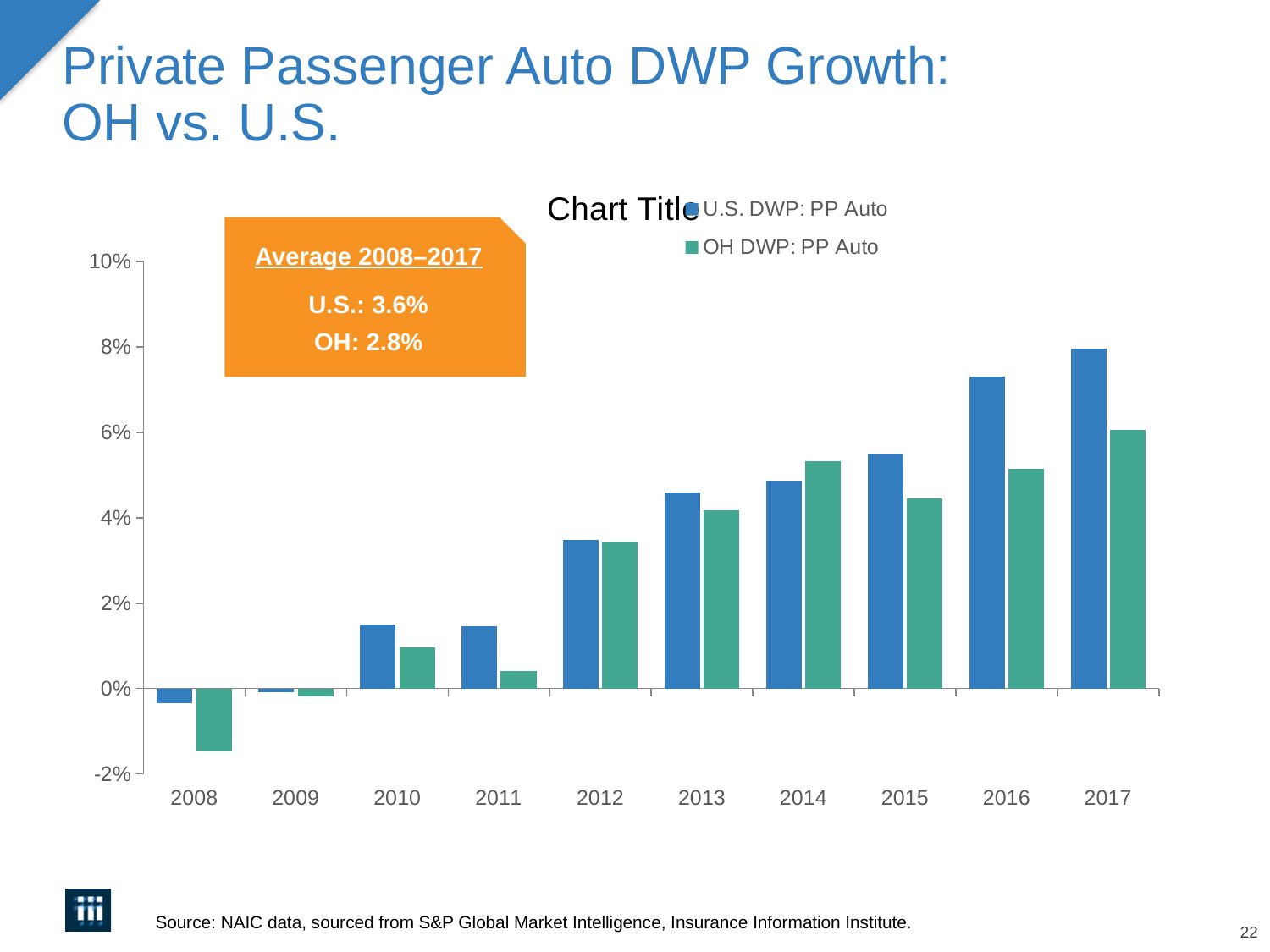
In 2016, which is larger: U.S. DWP: PP Auto or OH DWP: PP Auto? U.S. DWP: PP Auto Is the value for OH DWP: PP Auto in 2016 greater or less than 6%? less According to the callout box, what is the U.S. average DWP growth for 2008–2017? 3.6% In which year is the OH DWP: PP Auto growth lowest? 2008 In which year is the U.S. DWP: PP Auto growth highest? 2017 How many series does the legend list? 2 What kind of chart is shown on the slide? Bar chart In 2014, which is larger: U.S. DWP: PP Auto or OH DWP: PP Auto? OH DWP: PP Auto Is the value for U.S. DWP: PP Auto in 2017 greater or less than 6%? greater Do the U.S. DWP: PP Auto values generally rise or fall from 2008 to 2017? Rise Is the value for OH DWP: PP Auto in 2008 greater or less than 0%? less How many years are shown on the x axis? 10